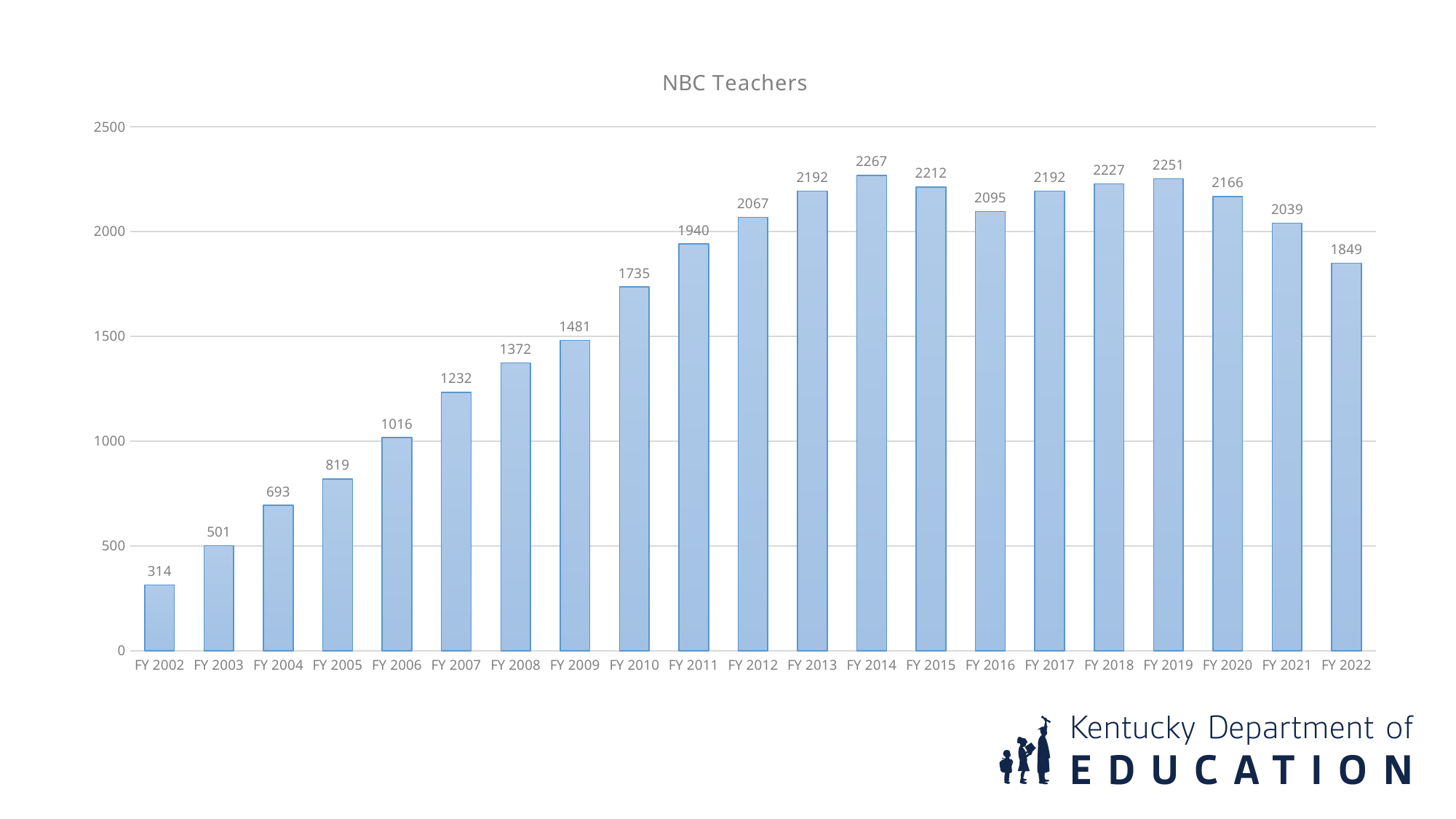
What is the title of the chart? NBC Teachers Is the value for FY 2011 greater or less than 2000? less Which fiscal year has the highest value? FY 2014 What is the difference between the values for FY 2014 and FY 2022? 418 What kind of chart is shown on the slide? bar chart What is the value for FY 2022? 1849 Which fiscal year has the lowest value? FY 2002 How many fiscal years are shown on the x axis? 21 What is the value for FY 2002? 314 What is the difference between the values for FY 2003 and FY 2002? 187 What is the value for FY 2014? 2267 Which is larger, the value for FY 2019 or the value for FY 2020? FY 2019